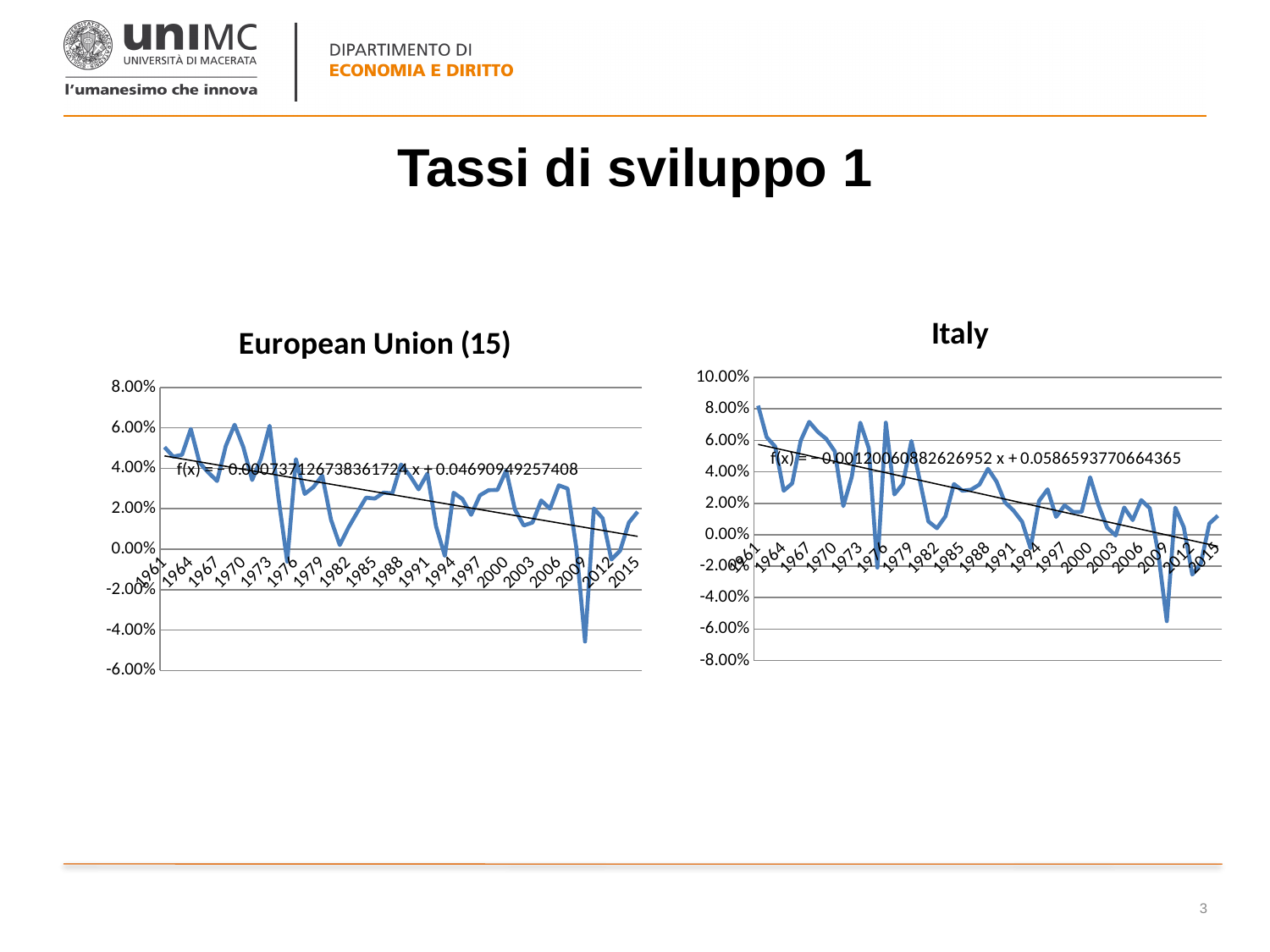
In the European Union (15) chart, which year has the lowest value? 2009 What is the title of the chart on the right side of the slide? Italy In the Italy chart, does the fitted trend line rise or fall from 1961 to 2015? fall What kind of chart is the Italy chart? line chart In the Italy chart, is the value for 1961 greater or less than 6.00%? greater In the European Union (15) chart, does the fitted trend line rise or fall across the years? fall In the Italy chart, which is larger, the value for 1961 or the value for 2015? 1961 What kind of chart is the European Union (15) chart? line chart In the Italy chart, which year has the highest value? 1961 In the Italy chart, which year has the lowest value? 2009 In the European Union (15) chart, is the value for 2009 greater or less than -4.00%? less In the Italy chart, is the value for 2009 greater or less than -4.00%? less